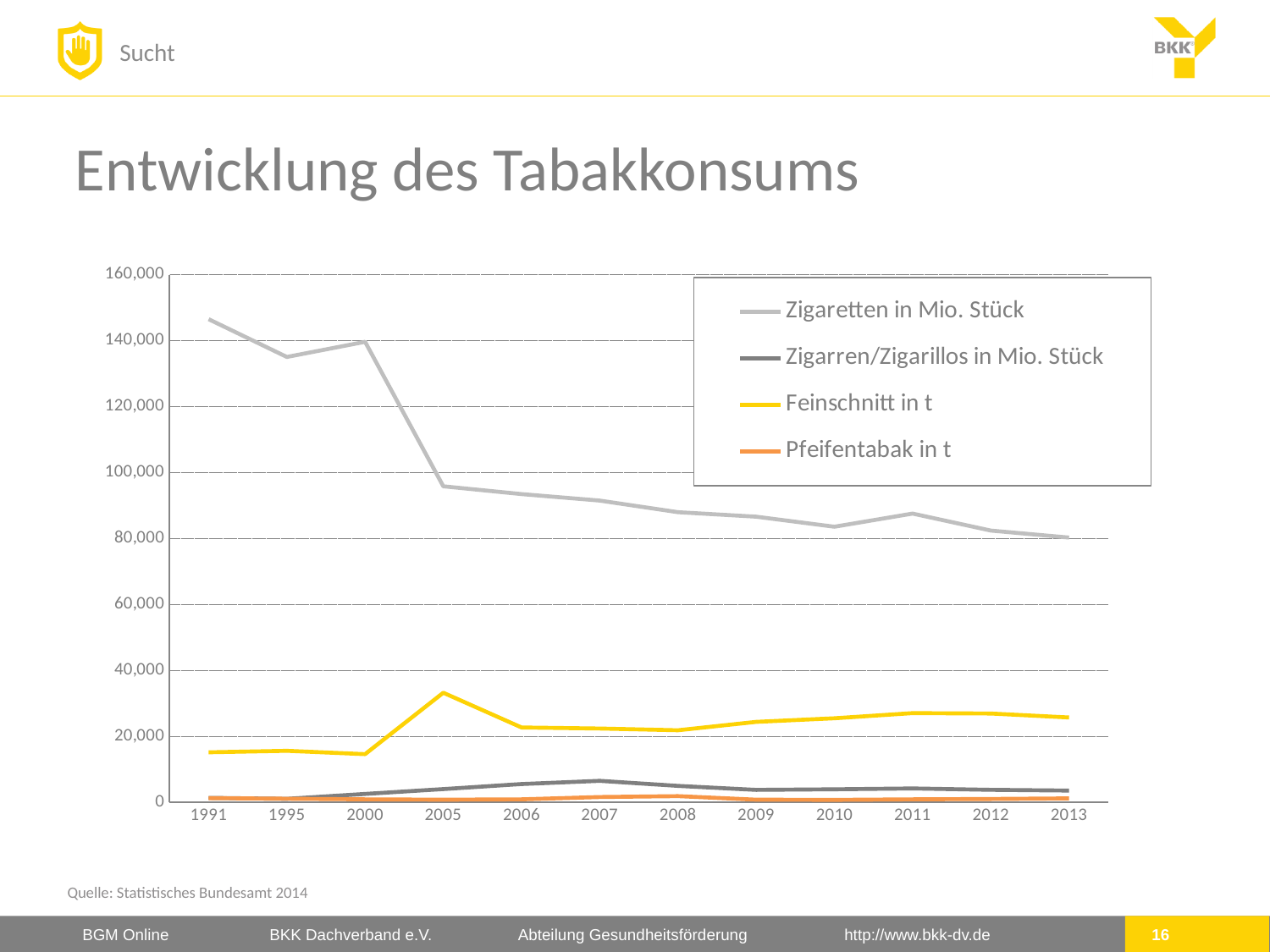
Is the value for Zigaretten in Mio. Stück in 2005 greater or less than 100,000? less How many years are shown on the x axis? 12 What kind of chart is shown on the slide? line chart Do the values for Zigaretten in Mio. Stück rise or fall from 1991 to 2013? fall In which year is the value for Feinschnitt in t highest? 2005 Which is larger in 2013, the value for Zigaretten in Mio. Stück or the value for Feinschnitt in t? Zigaretten in Mio. Stück In which year is the value for Zigaretten in Mio. Stück highest? 1991 Is the value for Zigaretten in Mio. Stück in 1991 greater or less than 140,000? greater What is the title of the slide containing the chart? Entwicklung des Tabakkonsums Which series is drawn in yellow in the chart? Feinschnitt in t How many series does the legend list? 4 Is the value for Feinschnitt in t in 2005 greater or less than 20,000? greater